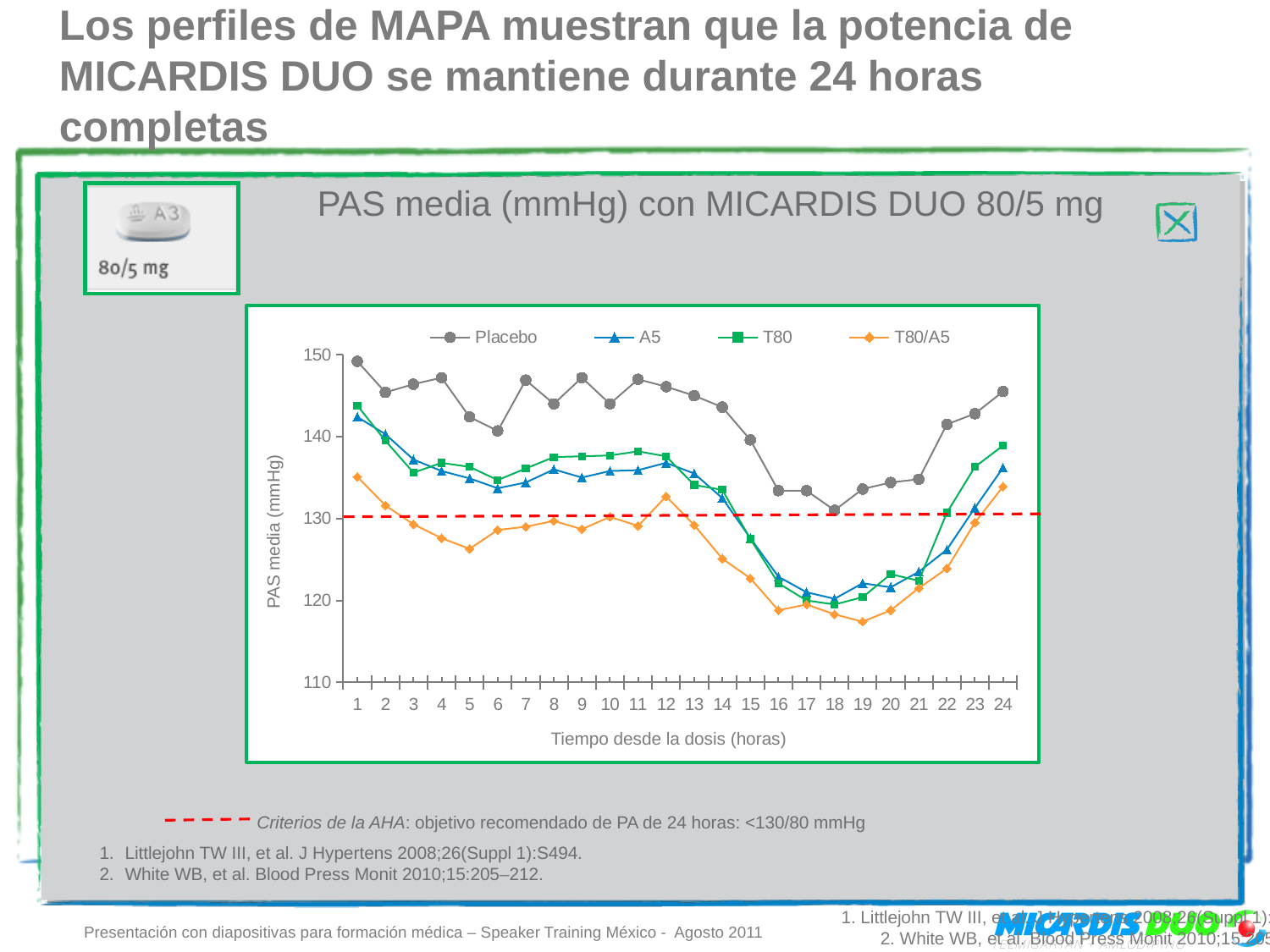
At hour 1, which is larger: the Placebo value or the T80/A5 value? Placebo How many series does the chart legend list? 4 Does the Placebo series rise or fall between hour 12 and hour 18? fall Which series has the highest value at hour 12? Placebo Which series has the lowest value at hour 1? T80/A5 What kind of chart is shown on the slide? line chart What does the red dashed horizontal line represent? Criterios de la AHA: objetivo recomendado de PA de 24 horas: <130/80 mmHg Is the T80/A5 value at hour 19 greater or less than 120? less Is the T80 value at hour 16 greater or less than 130? less Is the Placebo value at hour 1 greater or less than 140? greater What is the title of the chart? PAS media (mmHg) con MICARDIS DUO 80/5 mg How many time points (hours) are shown along the x axis? 24